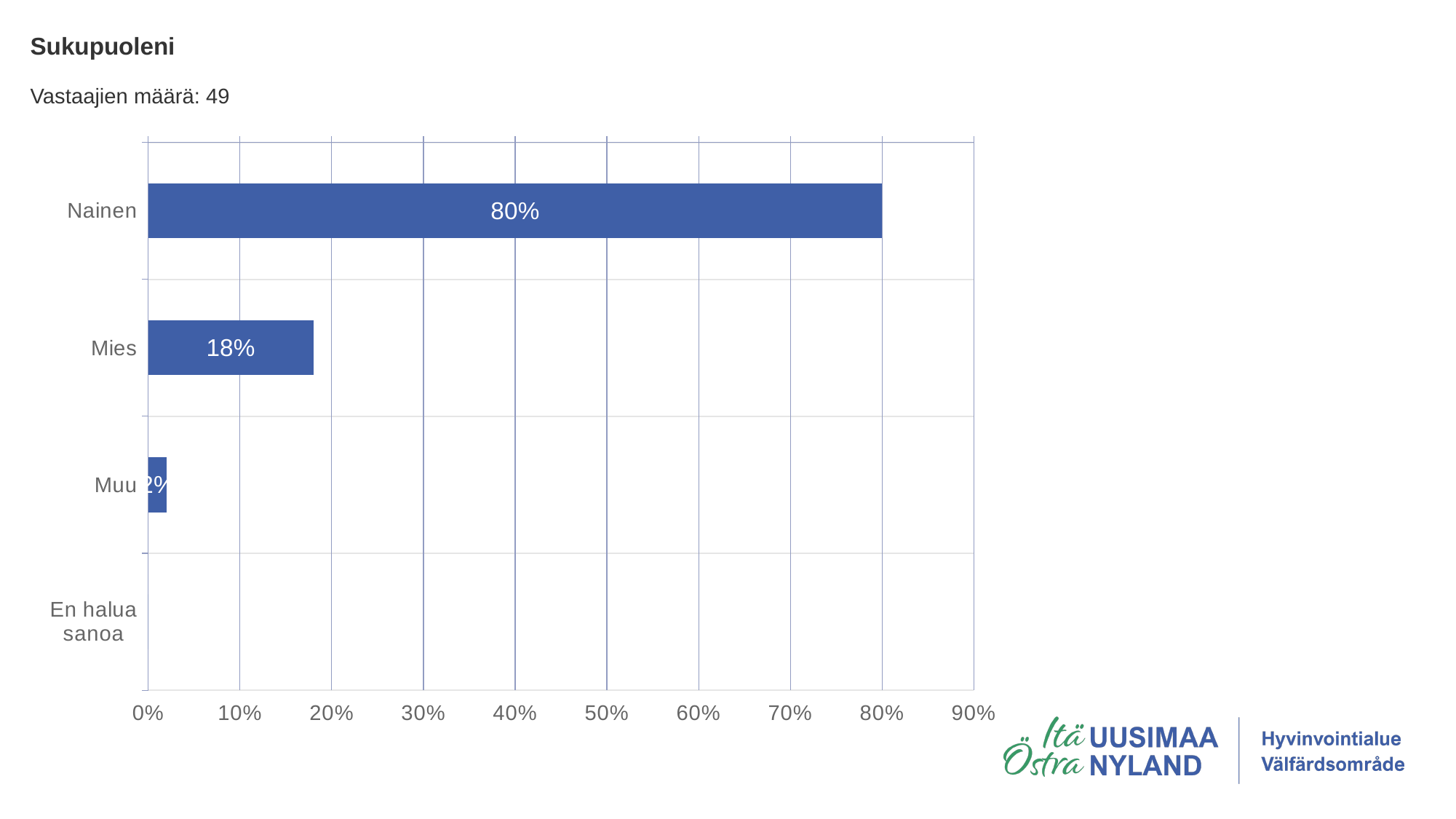
Which category with a visible bar has the lowest value? Muu What is the value for Mies? 18% How many respondents (Vastaajien määrä) are reported on the slide? 49 Which category has the highest value? Nainen What is the difference between the values for Nainen and Mies? 62% Which is larger, the value for Mies or the value for Muu? Mies What kind of chart is shown on the slide? bar chart What is the value for Nainen? 80% Is the value for Mies greater or less than 20%? less What is the value for Muu? 2% How many categories are shown on the y axis? 4 What is the title of the chart? Sukupuoleni